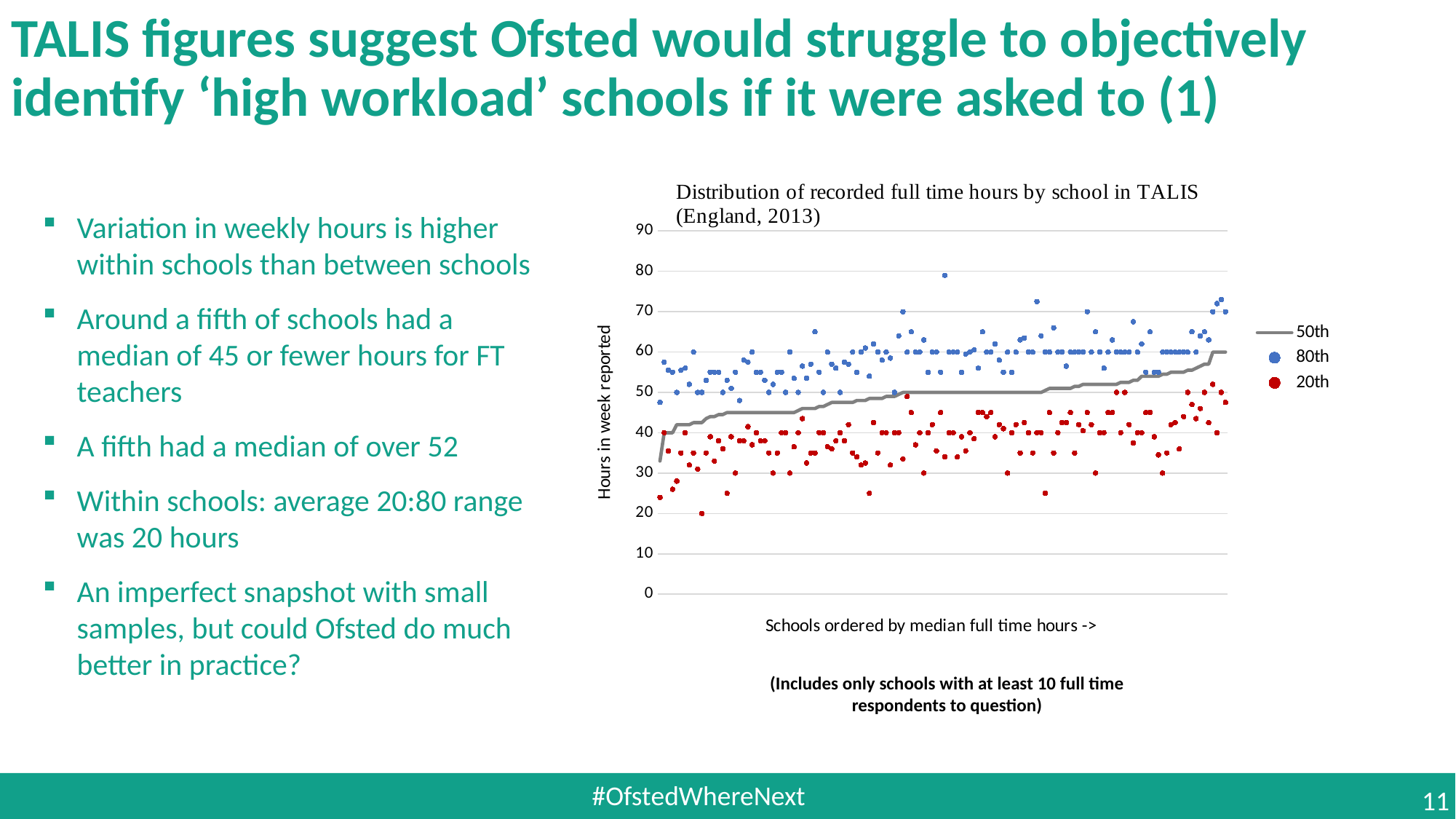
Is the highest plotted 80th percentile point greater or less than 70 hours? greater Which series generally has the highest values on the chart: 50th, 80th or 20th? 80th What are the three series named in the chart legend? 50th, 80th, 20th Does the 50th series line rise or fall from left to right along the x axis? Rise What is the highest tick value shown on the y axis of the chart? 90 How many series does the chart legend list? 3 What is the title of the chart? Distribution of recorded full time hours by school in TALIS (England, 2013) Is the value of the 50th series line at the far left of the chart greater or less than 40 hours? less Is the lowest plotted 20th percentile point greater or less than 30 hours? less What kind of chart is shown on the slide? Scatter chart with a line Which series generally has the lowest values on the chart: 50th, 80th or 20th? 20th